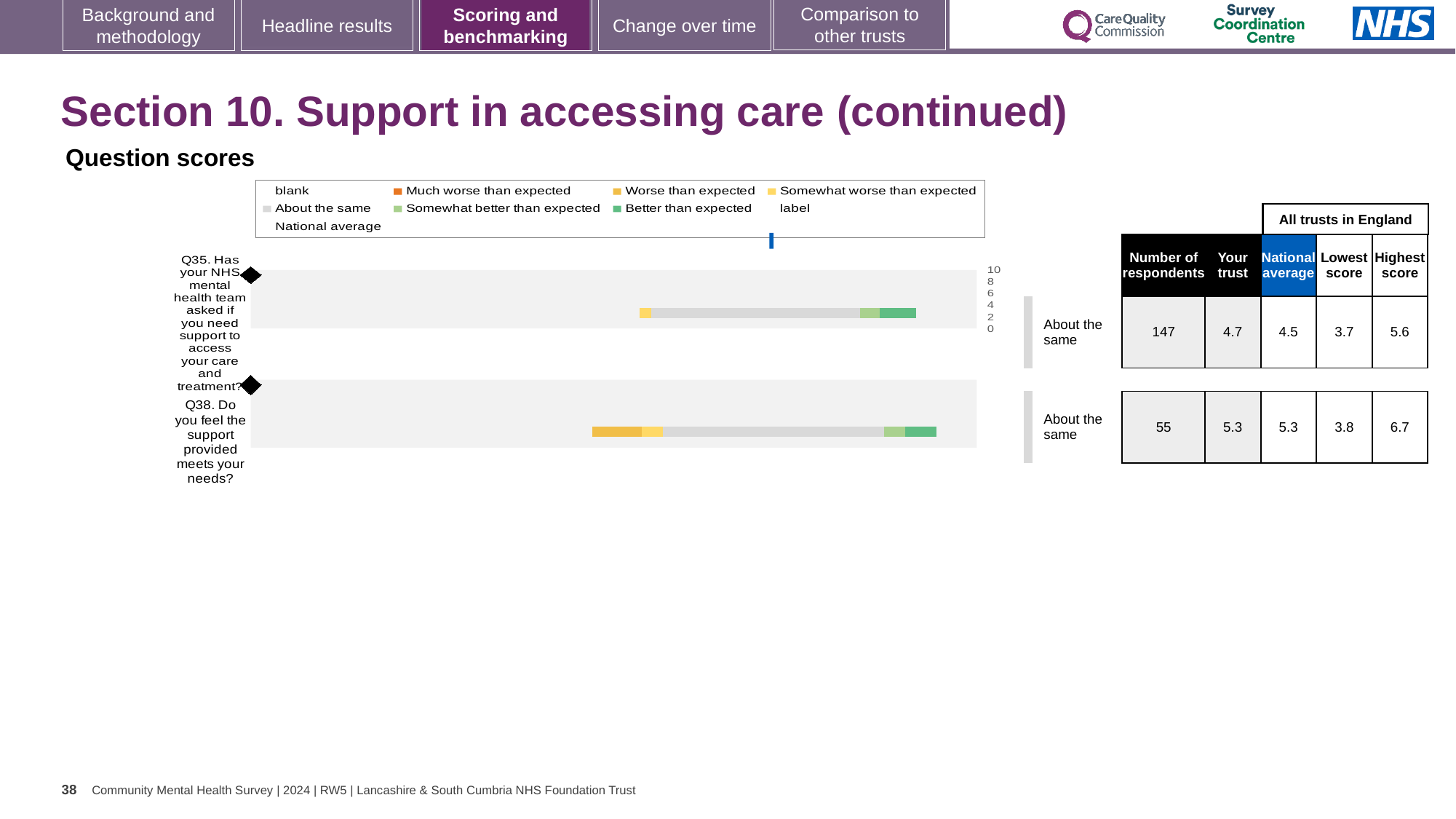
How many respondents answered Q38? 55 What is the highest score across all trusts in England for Q38? 6.7 What is the national average score for Q35? 4.5 How many questions are plotted in the question scores chart? 2 What is the 'Your trust' score for Q38 (Do you feel the support provided meets your needs?)? 5.3 What is the difference between the trust's score and the national average for Q35? 0.2 What benchmark category is shown for Q38 in the question scores chart? About the same What is the 'Your trust' score for Q35 (Has your NHS mental health team asked if you need support to access your care and treatment?)? 4.7 What kind of chart is used to show the question scores on this slide? bar chart What is the lowest score across all trusts in England for Q35? 3.7 Which question has the higher 'Your trust' score, Q35 or Q38? Q38 Which question has more respondents, Q35 or Q38? Q35